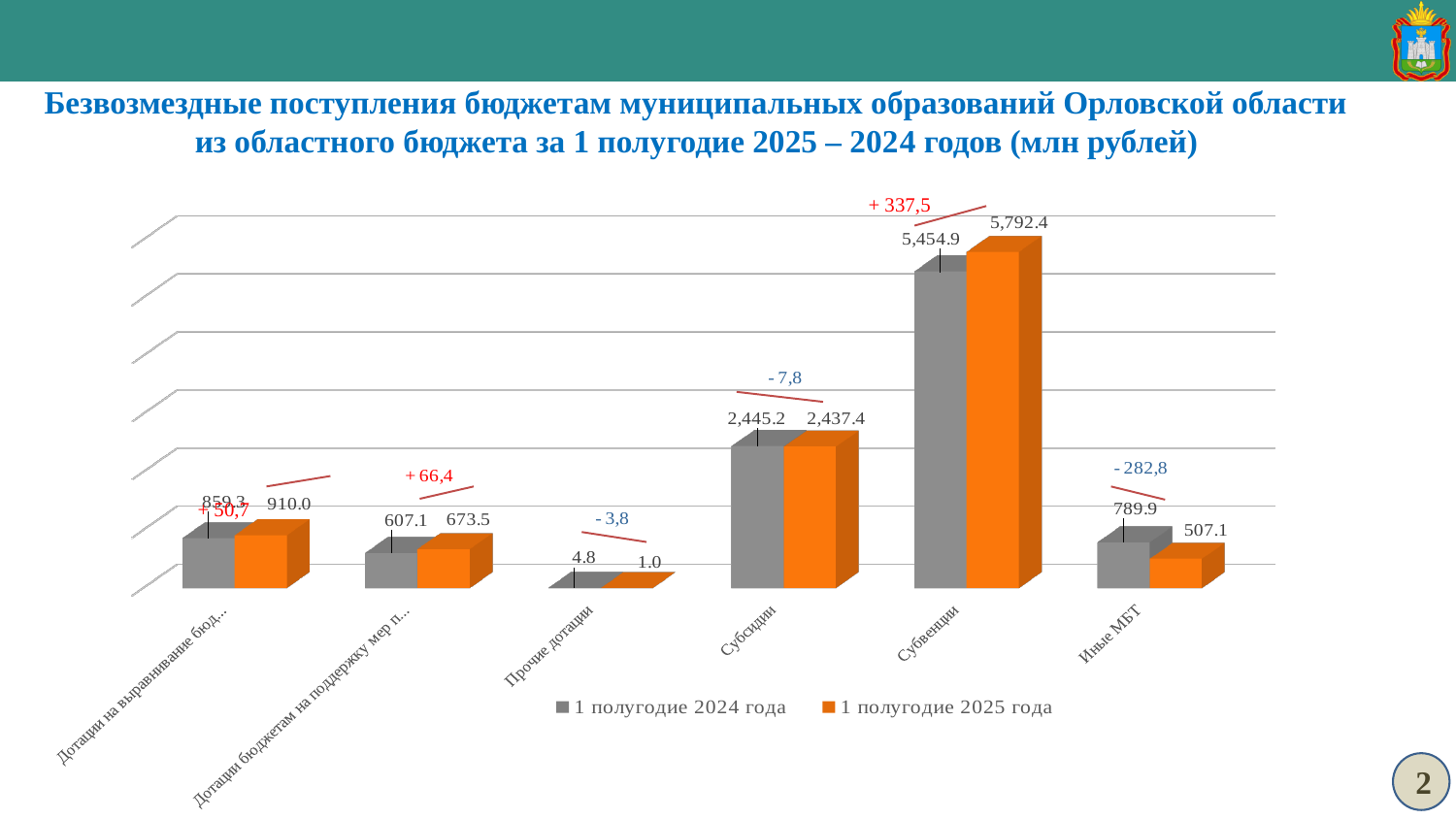
What is the value for Прочие дотации in 1 полугодие 2024 года? 4.8 Which category has the highest value in 1 полугодие 2025 года? Субвенции For Субсидии, which series has the larger value: 1 полугодие 2024 года or 1 полугодие 2025 года? 1 полугодие 2024 года What is the value for Иные МБТ in 1 полугодие 2025 года? 507.1 Which category has the lowest value in 1 полугодие 2024 года? Прочие дотации What is the value for Субсидии in 1 полугодие 2024 года? 2,445.2 For Иные МБТ, which series has the larger value: 1 полугодие 2024 года or 1 полугодие 2025 года? 1 полугодие 2024 года How many categories are shown on the x axis of the chart? 6 How many series does the legend list? 2 By how much did the value for Субвенции increase from 1 полугодие 2024 года to 1 полугодие 2025 года? 337.5 What kind of chart is shown on the slide? Bar chart What is the value for Субвенции in 1 полугодие 2025 года? 5,792.4